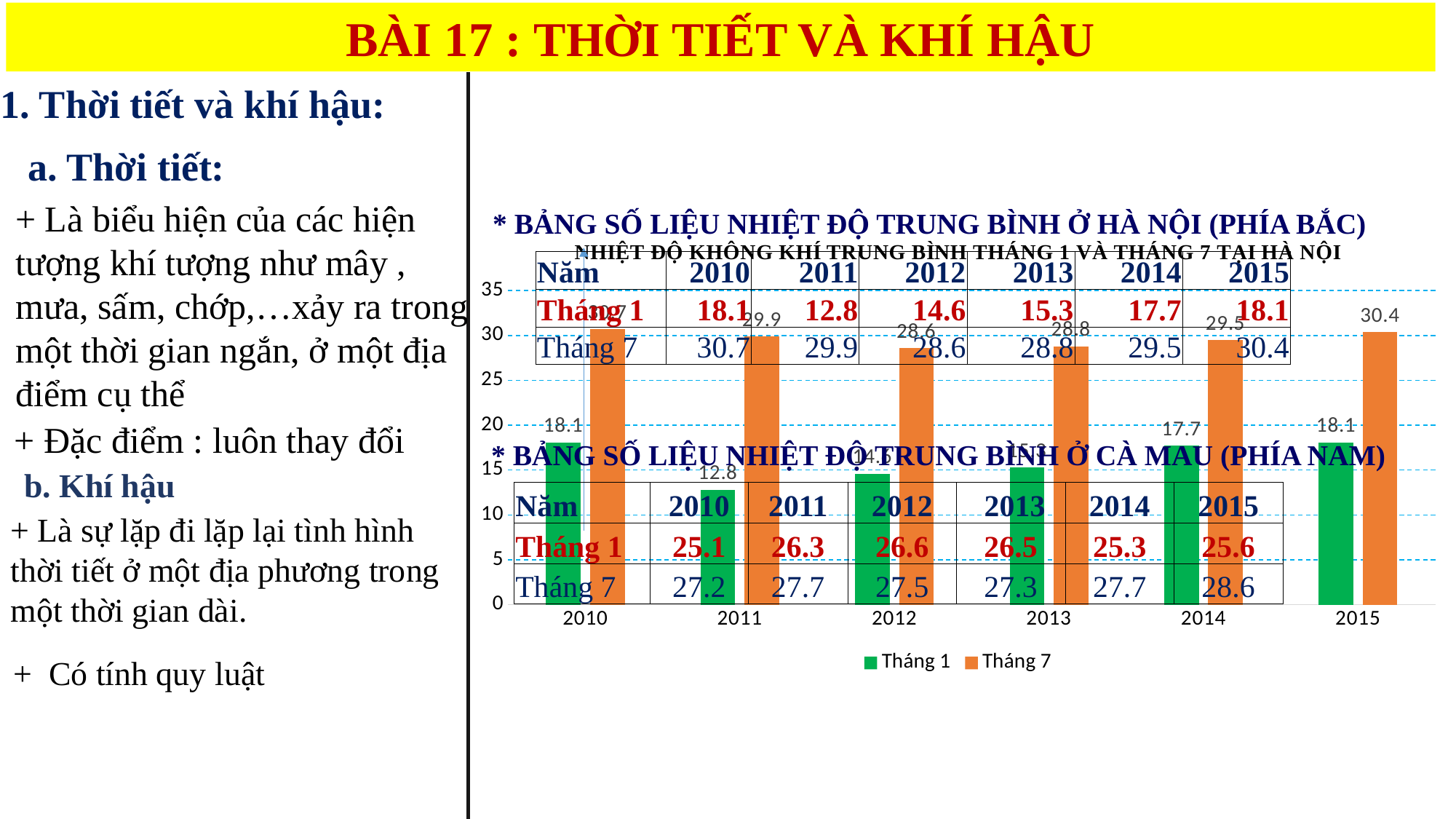
Is the Tháng 1 value for 2011 greater or less than 15? less What type of chart is shown on the slide? bar chart How many years are shown on the x axis of the chart? 6 Which year has the highest Tháng 7 value in the chart? 2010 What is the difference between the Tháng 7 and Tháng 1 values for 2011? 17.1 Which year has the lowest Tháng 1 value in the chart? 2011 What is the Tháng 7 value for 2015 in the chart? 30.4 How many series does the chart legend list? 2 What is the Tháng 1 value for 2014 in the chart? 17.7 What is the Tháng 1 value for 2011 in the chart? 12.8 What is the Tháng 7 value for 2011 in the chart? 29.9 Which colour represents the Tháng 7 series in the chart? orange